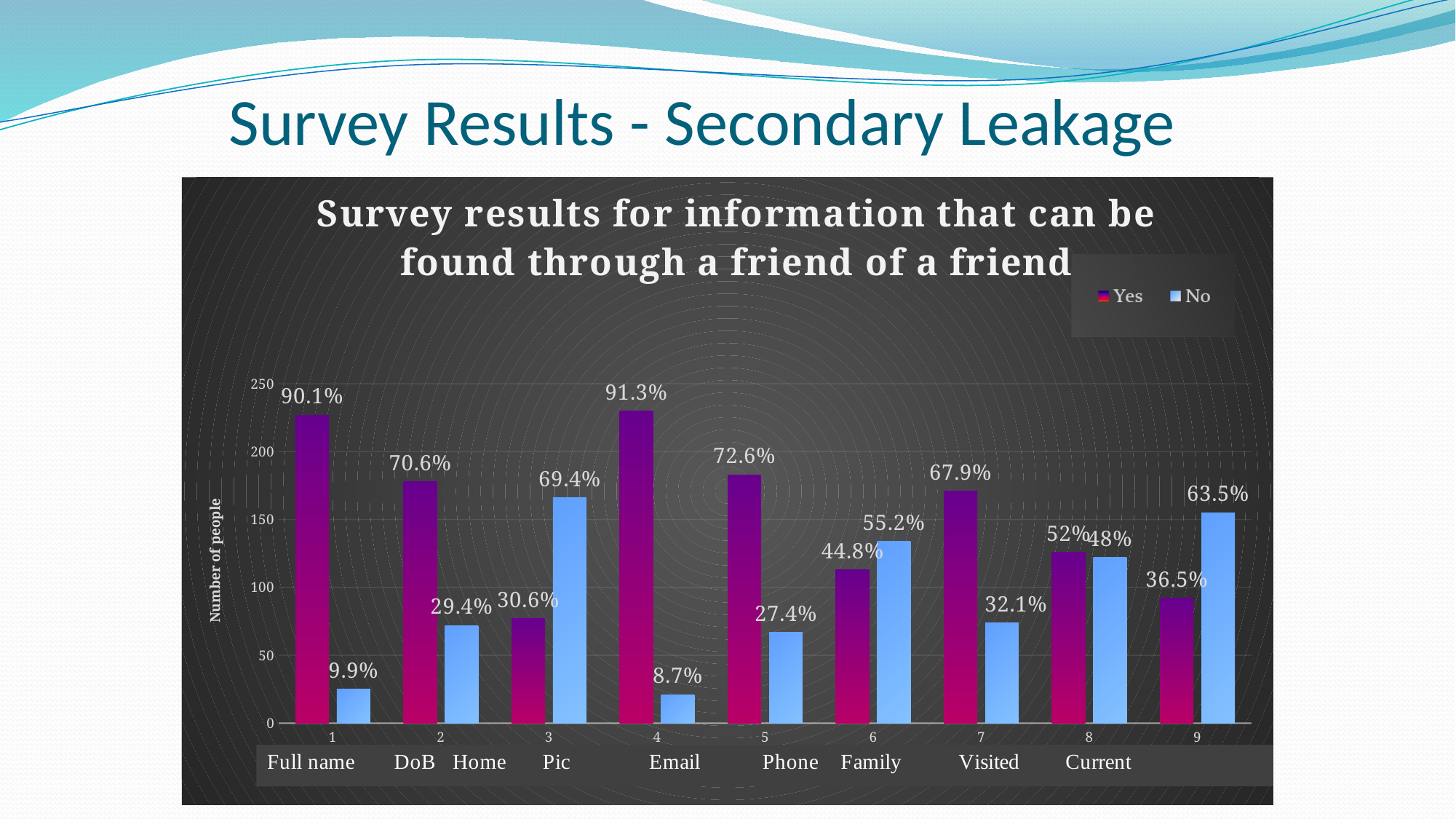
What is the Yes value for category 4? 91.3% What is the difference between the Yes and No values for category 1? 80.2% What is the Yes value for category 8? 52% Which category has the highest Yes value? 4 What kind of chart is shown on the slide? bar chart How many numbered categories are plotted along the x axis? 9 What is the No value for category 3? 69.4% How many series does the legend list? 2 What is the title of the vertical axis? Number of people Which category has the lowest No value? 4 For category 6, which is larger, the Yes value or the No value? No What are the two entries in the legend? Yes, No